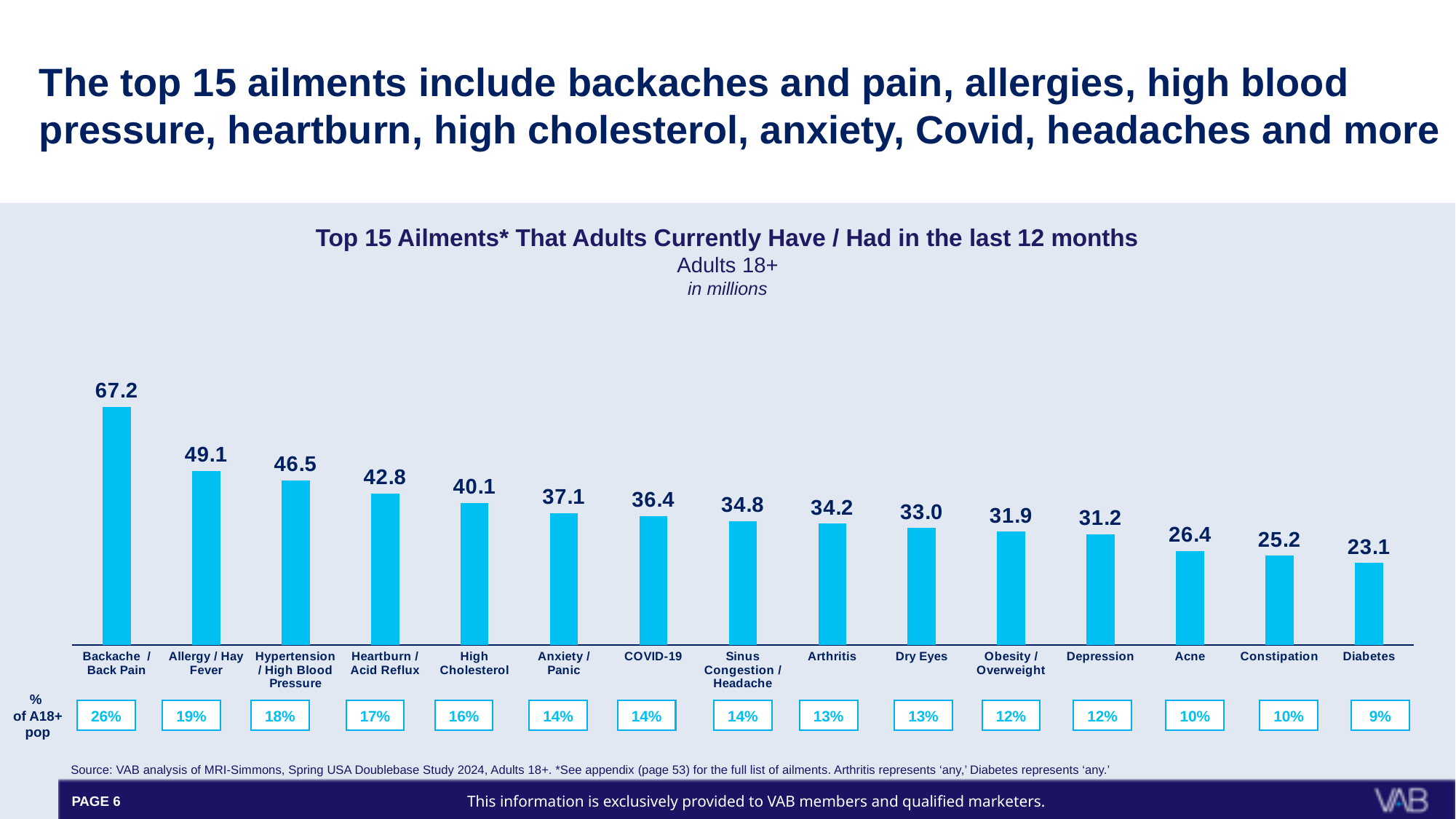
Which ailment has the lowest value? Diabetes Which ailment has the highest value? Backache / Back Pain How many ailments are shown in the chart? 15 What is the title of the chart? Top 15 Ailments* That Adults Currently Have / Had in the last 12 months What is the value for COVID-19? 36.4 Which is larger, the value for Acne or the value for Constipation? Acne What is the difference between the values for Backache / Back Pain and Diabetes? 44.1 What is the value for Backache / Back Pain? 67.2 What is the value for Dry Eyes? 33.0 What kind of chart is shown on the slide? Bar chart What is the difference between the values for Allergy / Hay Fever and Hypertension / High Blood Pressure? 2.6 Do the values rise or fall from left to right across the chart? Fall